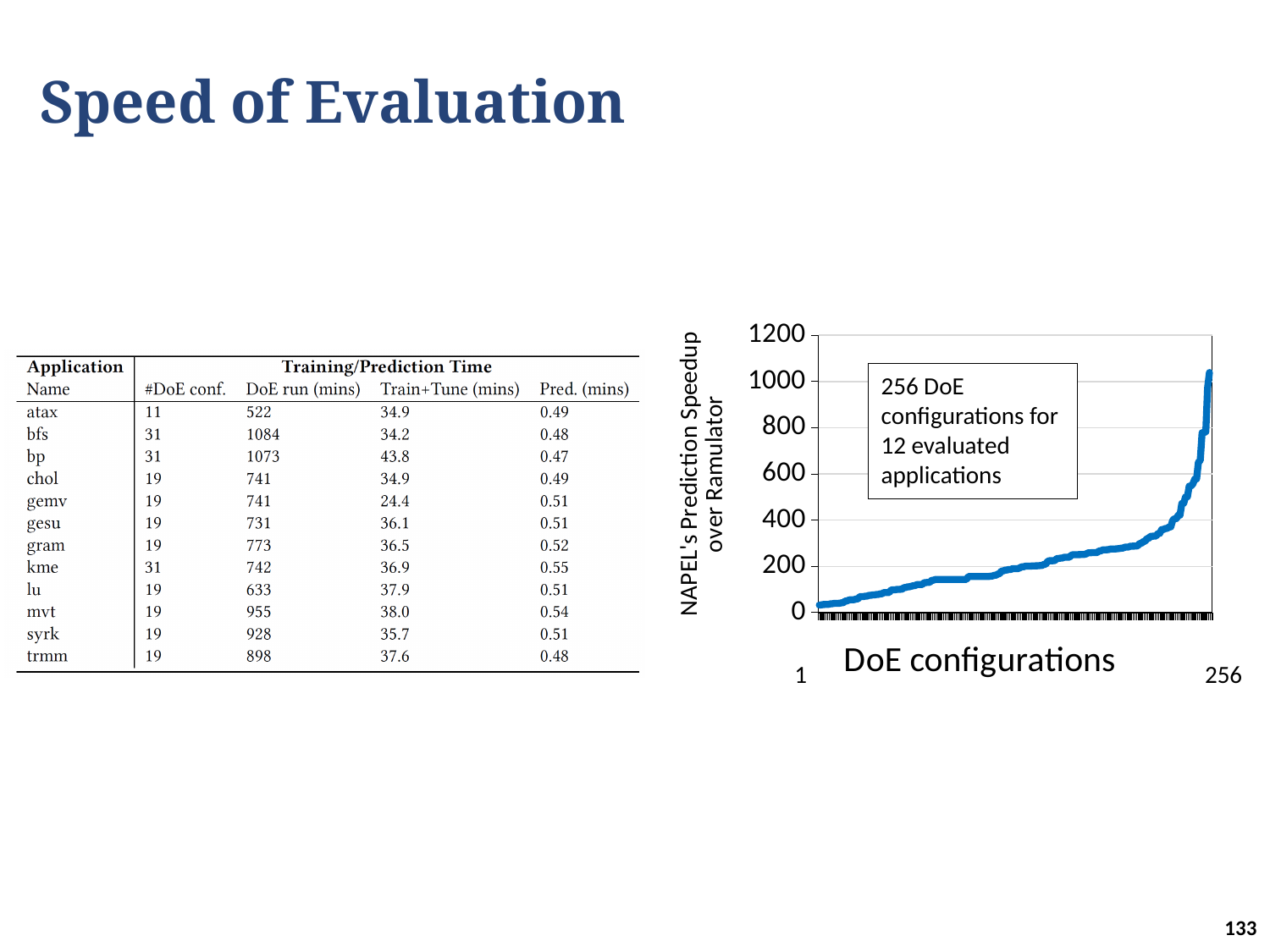
What is the label of the y axis in the chart on the right? NAPEL's Prediction Speedup over Ramulator In the chart on the right, which end of the x axis has the larger speedup value, configuration 1 or configuration 256? 256 How many DoE configurations are plotted along the x axis of the chart on the right? 256 What is the label of the x axis in the chart on the right? DoE configurations What is the highest tick value shown on the y axis of the chart on the right? 1200 In the chart on the right, do the values rise or fall as you move from configuration 1 to configuration 256 along the x axis? rise In the chart on the right, is the speedup value at DoE configuration 1 greater or less than 200? less What kind of chart is shown on the right side of the slide? line chart In the chart on the right, is the speedup value at the midpoint of the x axis (around configuration 128) greater or less than 400? less In the chart on the right, is the highest plotted speedup value greater or less than 800? greater